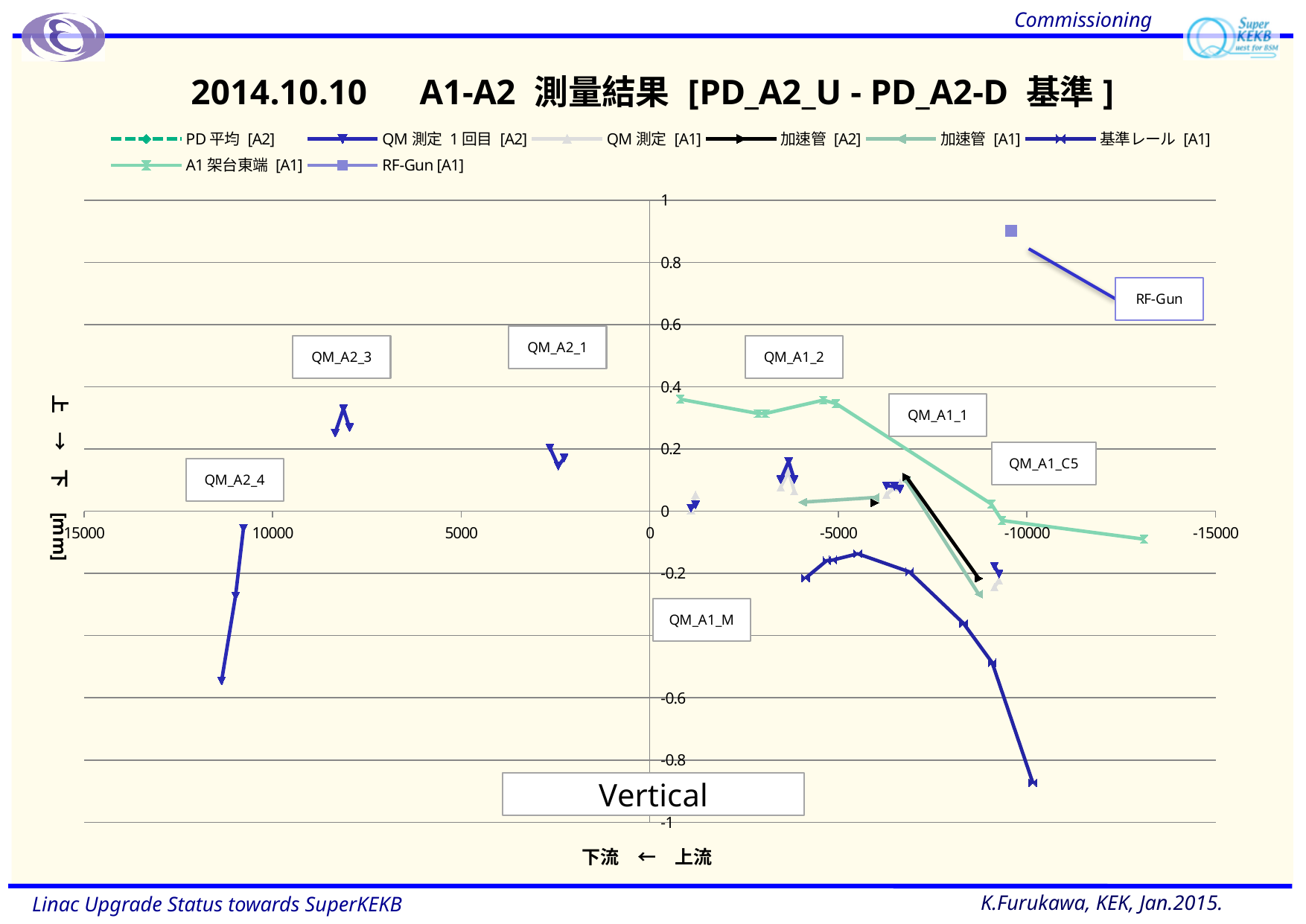
Is the leftmost point of the A1 架台東端 [A1] series greater or less than 0.2? greater Which series contains the lowest plotted point on the chart? 基準レール [A1] Is the lowest point of the QM 測定 1 回目 [A2] series near QM_A2_4 greater or less than -0.4? less Which series contains the highest plotted point on the chart? RF-Gun [A1] Is the lowest point of the 基準レール [A1] series greater or less than -0.8? less How many series does the legend list? 8 Which is larger: the RF-Gun [A1] point or the highest point of the A1 架台東端 [A1] series? RF-Gun [A1] What kind of chart is shown on the slide? line chart What unit is shown on the vertical axis label? [mm] Do the values of the A1 架台東端 [A1] series rise or fall from left to right along the x axis? fall What is the title of the chart? 2014.10.10 A1-A2 測量結果 [PD_A2_U - PD_A2-D 基準]